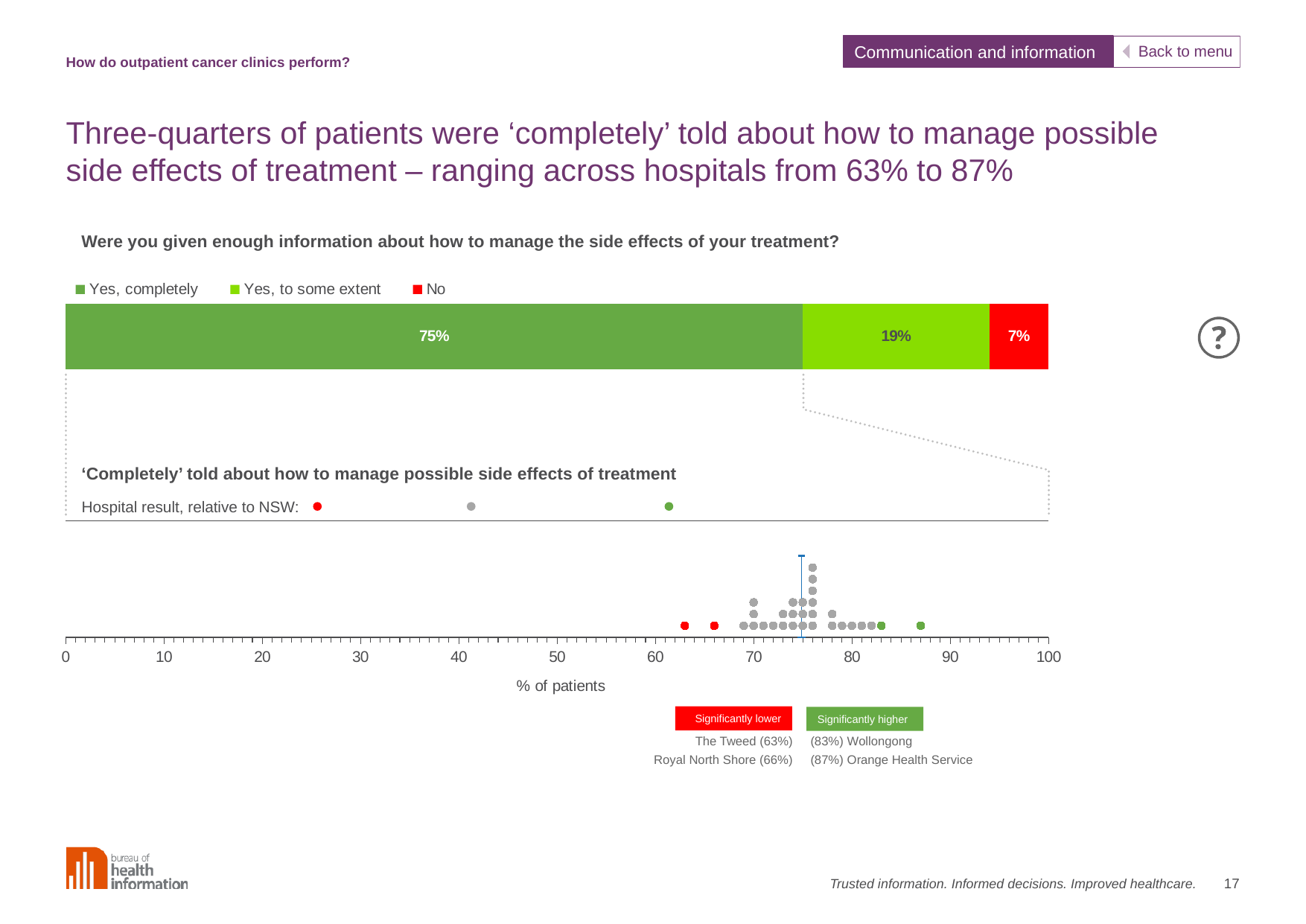
In the hospital dot plot, what is the difference between Orange Health Service and The Tweed? 24 percentage points In the hospital dot plot, how many hospitals are marked as significantly lower than NSW? 2 In the hospital dot plot, which hospital has the highest result? Orange Health Service How many response categories does the legend of the stacked bar chart list? 3 In the stacked bar chart, how many percentage points larger is 'Yes, completely' than 'Yes, to some extent'? 56 percentage points In the stacked bar chart, what percentage of patients answered 'Yes, completely'? 75% In the hospital dot plot, what is the result for The Tweed? 63% In the stacked bar chart, which response category has the largest share? Yes, completely What kind of chart is the top chart showing the survey responses? Stacked bar chart In the stacked bar chart, what percentage of patients answered 'No'? 7% In the stacked bar chart, which response category has the smallest share? No In the stacked bar chart, what percentage of patients answered 'Yes, to some extent'? 19%